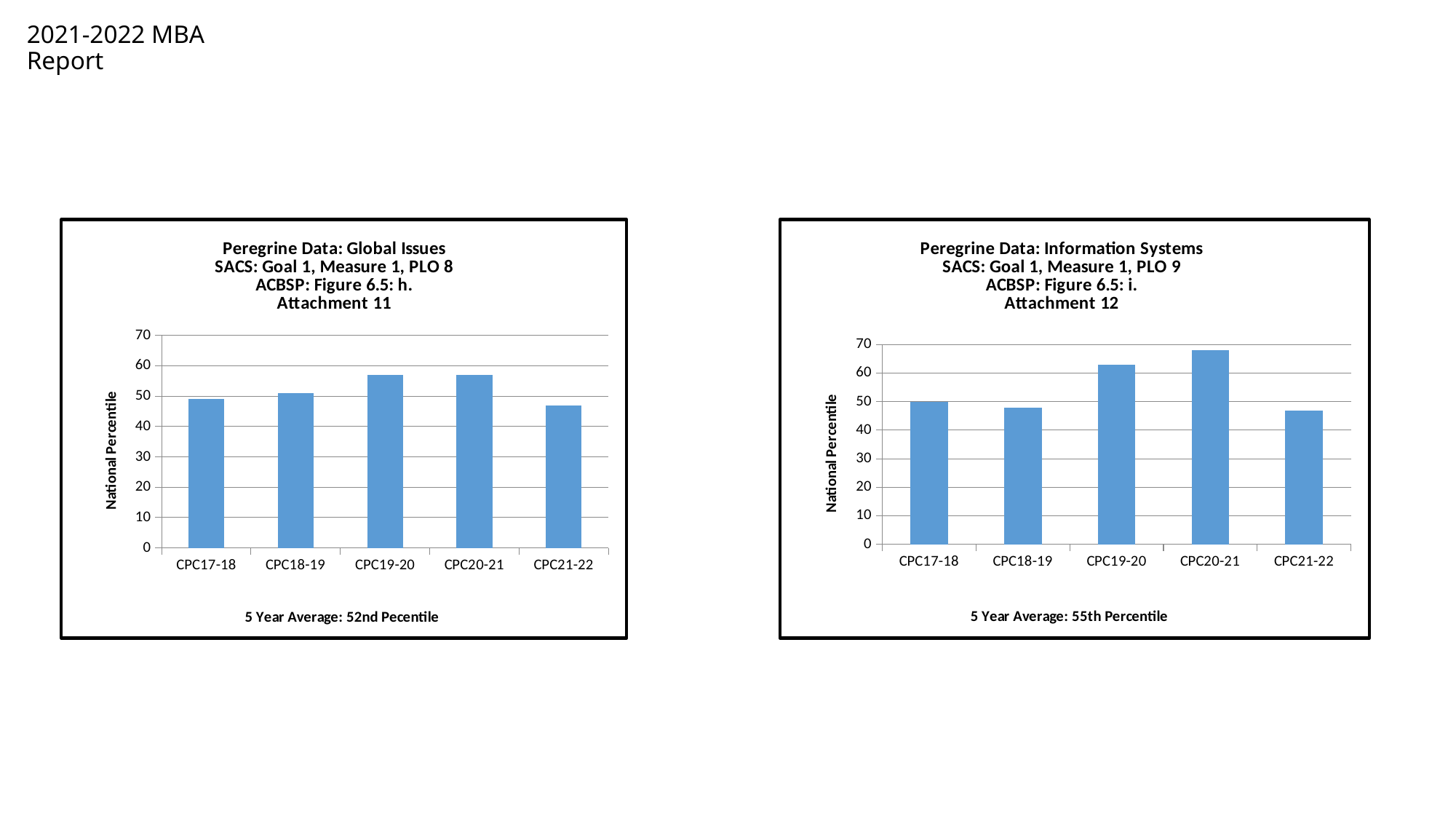
In the Peregrine Data: Information Systems chart, which is larger, the value for CPC19-20 or the value for CPC18-19? CPC19-20 In the Peregrine Data: Information Systems chart, which category has the highest value? CPC20-21 In the Peregrine Data: Information Systems chart, do the values rise or fall from CPC20-21 to CPC21-22? fall In the Peregrine Data: Information Systems chart, is the value for CPC21-22 greater or less than 50? less What kind of chart is the Peregrine Data: Global Issues chart on the left? bar chart What is the y-axis label of the Peregrine Data: Information Systems chart? National Percentile In the Peregrine Data: Global Issues chart, which is larger, the value for CPC19-20 or the value for CPC21-22? CPC19-20 In the Peregrine Data: Global Issues chart, is the value for CPC19-20 greater or less than 50? greater How many categories are shown on the x axis of the Peregrine Data: Information Systems chart on the right? 5 What 5 year average is stated below the Peregrine Data: Global Issues chart? 52nd Pecentile In the Peregrine Data: Information Systems chart, is the value for CPC20-21 greater or less than 60? greater